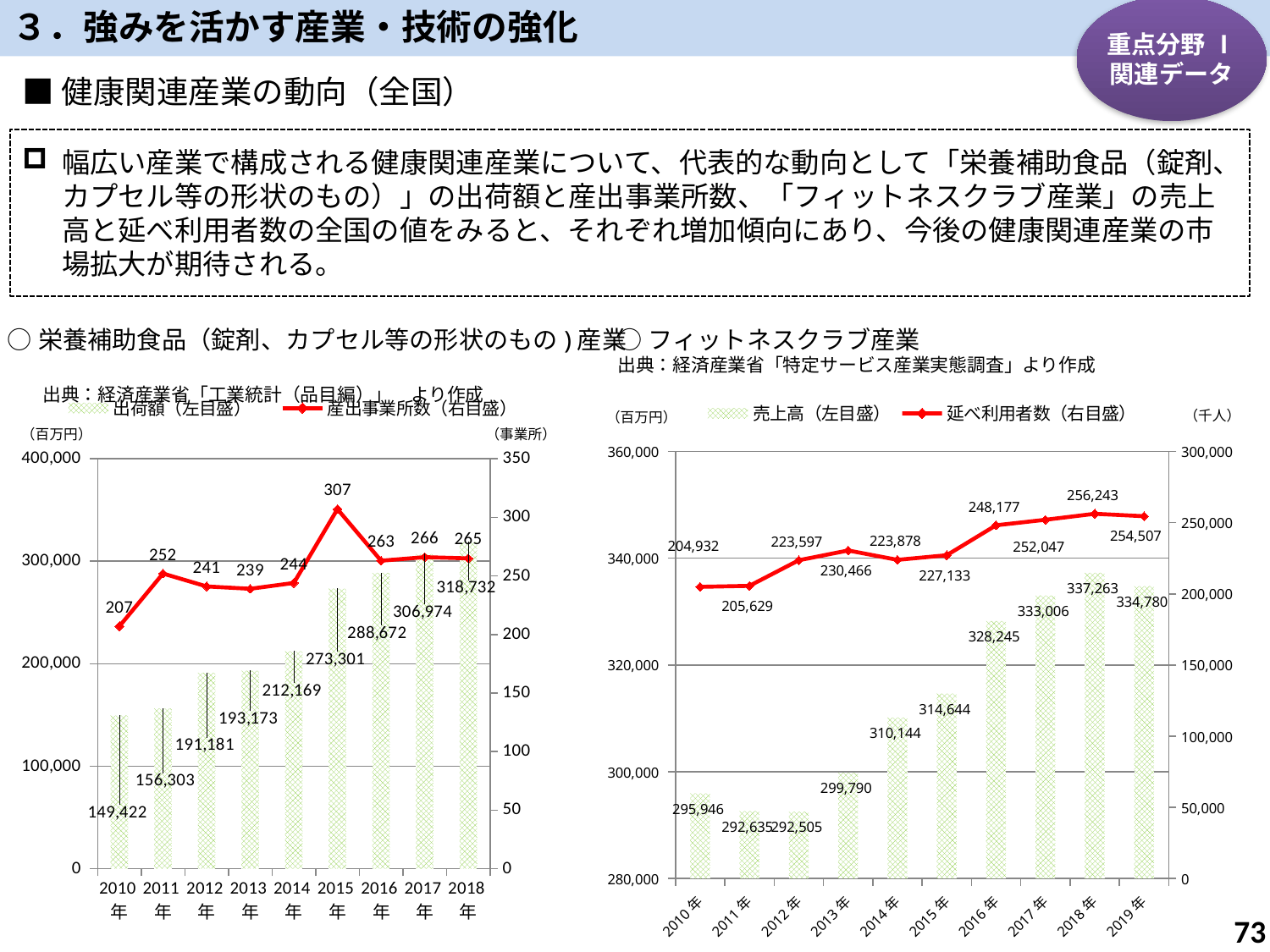
In the フィットネスクラブ産業 chart on the right, which is larger, the 延べ利用者数 for 2016年 or for 2014年? 2016年 In the フィットネスクラブ産業 chart on the right, what kind of chart is used for the 売上高 series? bar chart In the フィットネスクラブ産業 chart on the right, which year has the highest 売上高? 2018年 In the 栄養補助食品 chart on the left, which year has the lowest 出荷額? 2010年 In the 栄養補助食品 chart on the left, how many years are shown on the x axis? 9 In the 栄養補助食品 chart on the left, what is the difference in 出荷額 between 2018年 and 2010年? 169,310 In the フィットネスクラブ産業 chart on the right, what is the 売上高 value for 2016年? 328,245 In the 栄養補助食品 chart on the left, does the 出荷額 generally rise or fall from 2010年 to 2018年? rise In the フィットネスクラブ産業 chart on the right, how many series does the legend list? 2 In the フィットネスクラブ産業 chart on the right, what is the 延べ利用者数 value for 2018年? 256,243 In the 栄養補助食品 chart on the left, what is the 出荷額 value for 2018年? 318,732 In the 栄養補助食品 chart on the left, what is the 産出事業所数 value for 2015年? 307